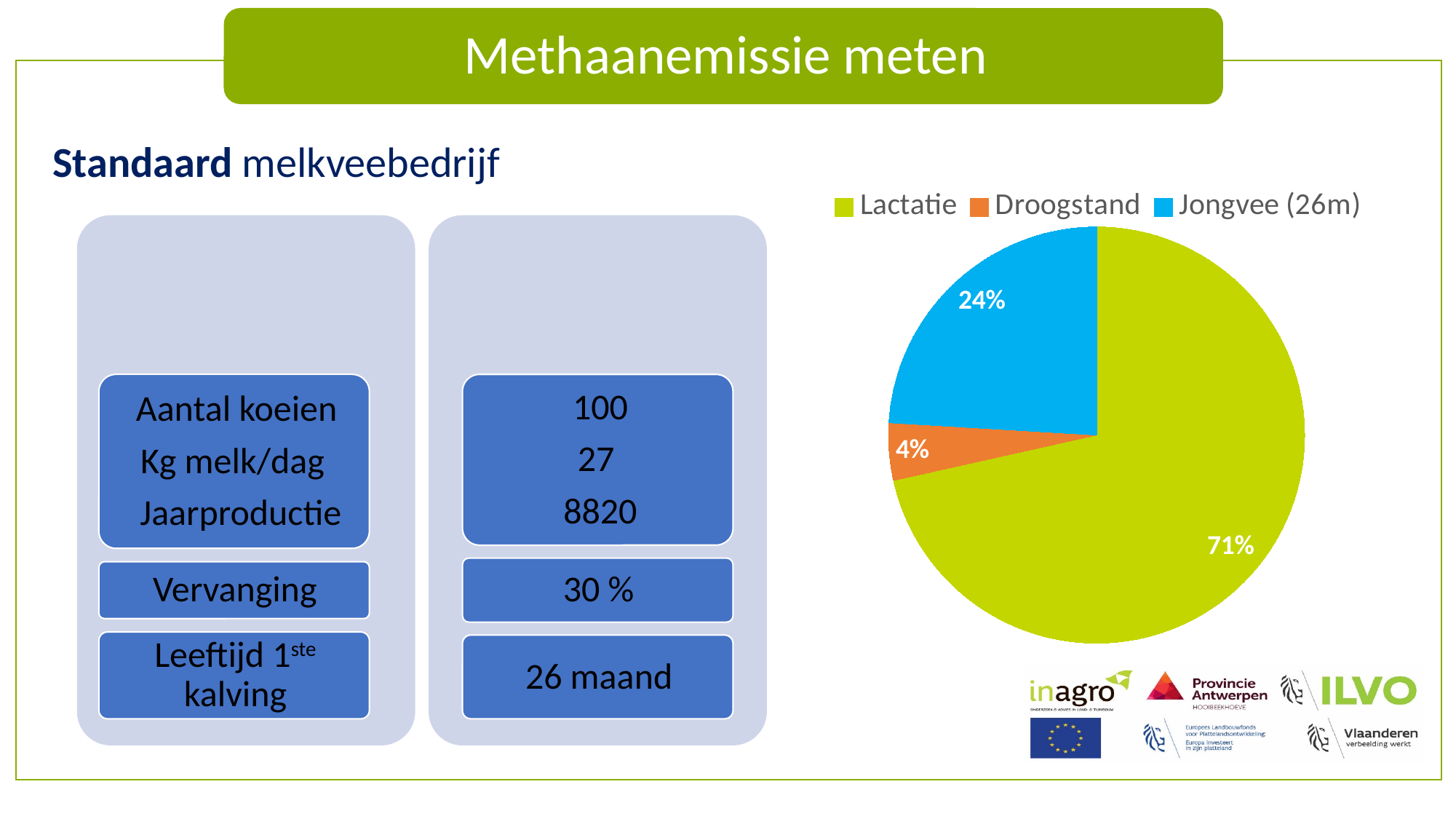
What share of the pie does Droogstand have? 4% What colour is the Droogstand slice in the pie chart? orange What colour is the Lactatie slice in the pie chart? green What share of the pie does Lactatie have? 71% Which is larger, the Jongvee (26m) slice or the Droogstand slice? Jongvee (26m) What share of the pie does Jongvee (26m) have? 24% How many slices does the pie chart have? 3 Which category has the largest slice of the pie? Lactatie How many categories does the legend of the pie chart list? 3 What is the difference in percentage points between the Lactatie and Jongvee (26m) slices? 47 What kind of chart is shown on the slide? pie chart Which category has the smallest slice of the pie? Droogstand